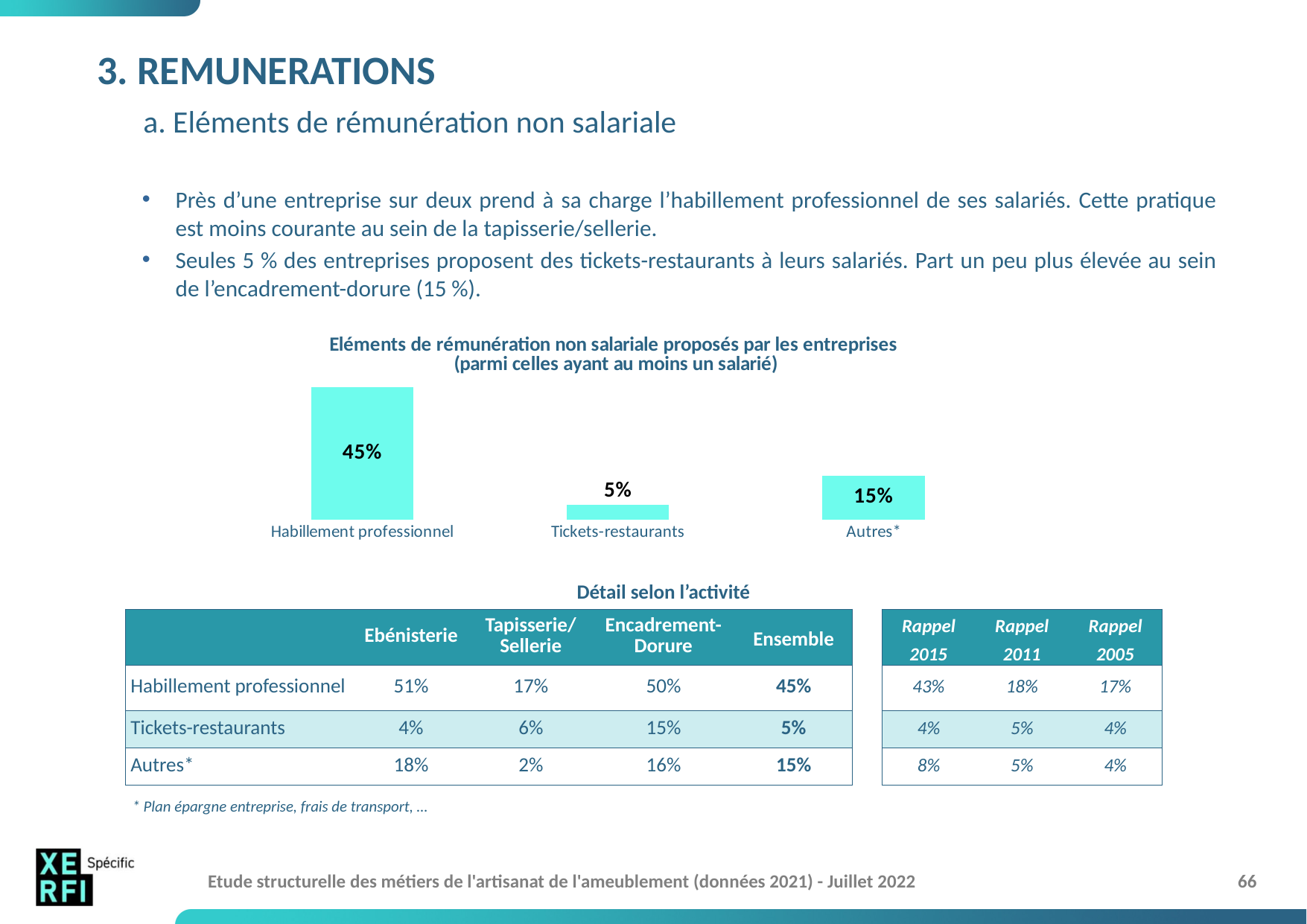
What is the value for Tickets-restaurants in the chart? 5% What is the title of the chart? Eléments de rémunération non salariale proposés par les entreprises (parmi celles ayant au moins un salarié) What is the difference between the values for Autres* and Tickets-restaurants? 10% Which is larger, the value for Autres* or the value for Tickets-restaurants? Autres* What kind of chart is shown on the slide? Bar chart What colour are the bars in the chart? Turquoise How many categories are shown in the chart? 3 What is the value for Habillement professionnel in the chart? 45% Which category has the lowest value in the chart? Tickets-restaurants Which category has the highest value in the chart? Habillement professionnel What is the value for Autres* in the chart? 15% What is the difference between the values for Habillement professionnel and Autres*? 30%